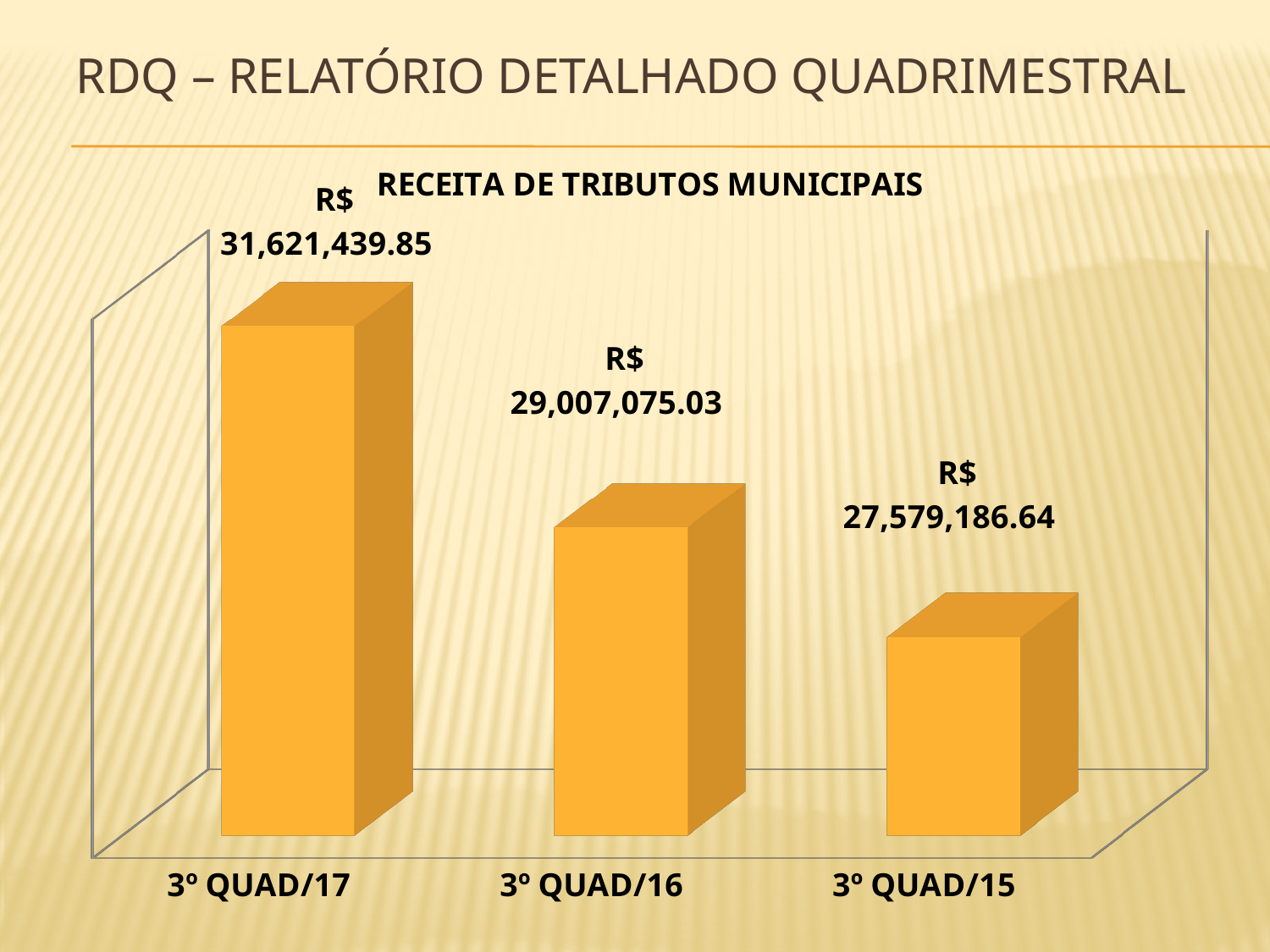
What is the value for 3º QUAD/16? R$ 29,007,075.03 Which category has the highest value? 3º QUAD/17 What kind of chart is shown on the slide? Bar chart What is the difference between the values for 3º QUAD/17 and 3º QUAD/16? R$ 2,614,364.82 What is the difference between the values for 3º QUAD/16 and 3º QUAD/15? R$ 1,427,888.39 What is the value for 3º QUAD/15? R$ 27,579,186.64 What is the value for 3º QUAD/17? R$ 31,621,439.85 What is the difference between the values for 3º QUAD/17 and 3º QUAD/15? R$ 4,042,253.21 Which category has the lowest value? 3º QUAD/15 Which is larger, the value for 3º QUAD/16 or the value for 3º QUAD/15? 3º QUAD/16 What is the title of the chart? RECEITA DE TRIBUTOS MUNICIPAIS How many categories are shown in the chart? 3